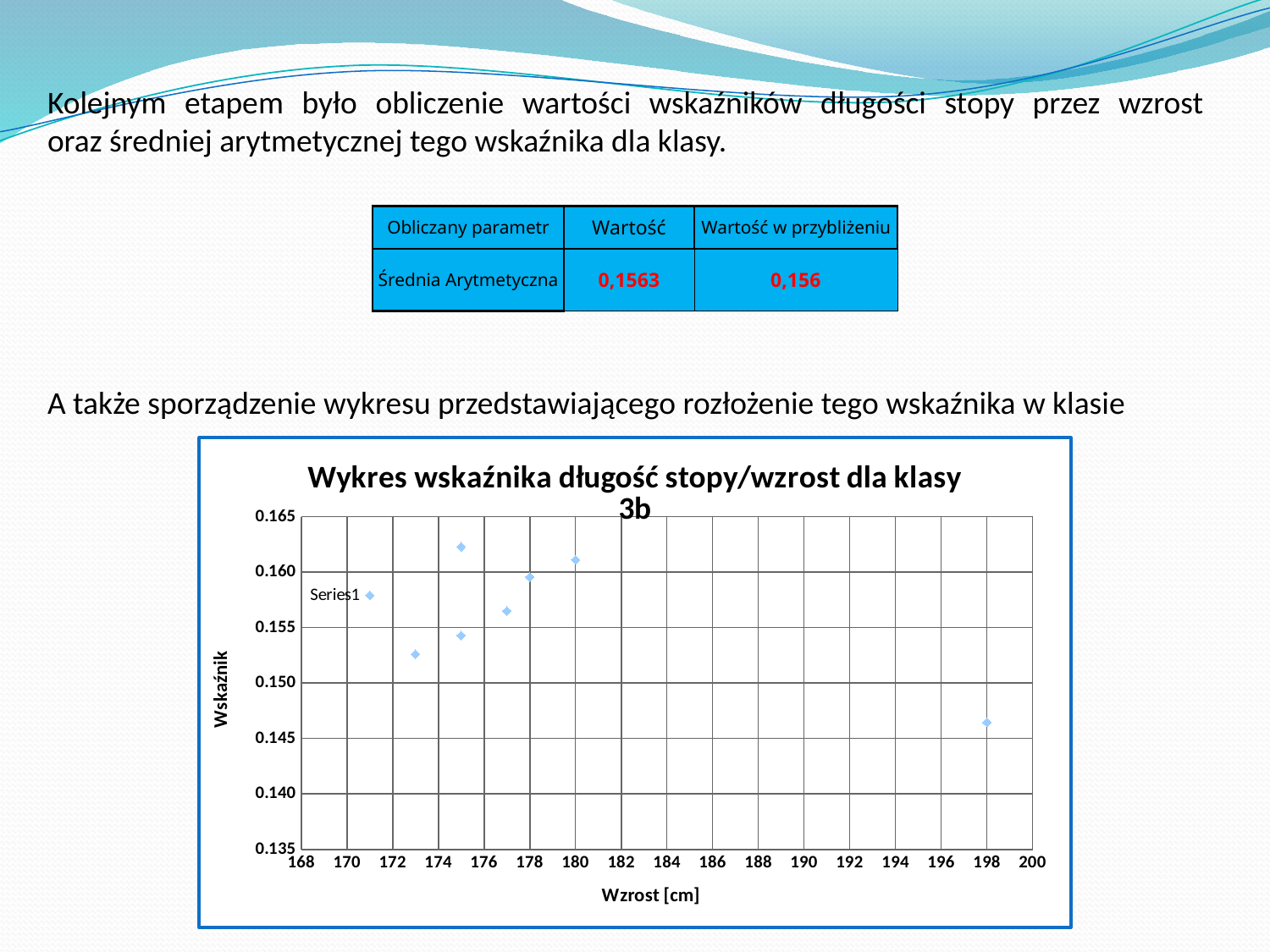
What kind of chart is shown on the slide? scatter chart What is the label of the x axis? Wzrost [cm] Which height (Wzrost) has the lowest Wskaźnik value on the chart? 198 Is the Wskaźnik value for the point at 180 cm greater or less than 0.160? greater Is the Wskaźnik value for the point at 173 cm greater or less than 0.155? less Is the Wskaźnik value for the point at 171 cm greater or less than 0.155? greater What is the title of the chart? Wykres wskaźnika długość stopy/wzrost dla klasy 3b Which point has the larger Wskaźnik value: the one at 173 cm or the one at 198 cm? 173 cm Which point has the larger Wskaźnik value: the one at 180 cm or the one at 171 cm? 180 cm How many data points are plotted on the chart? 8